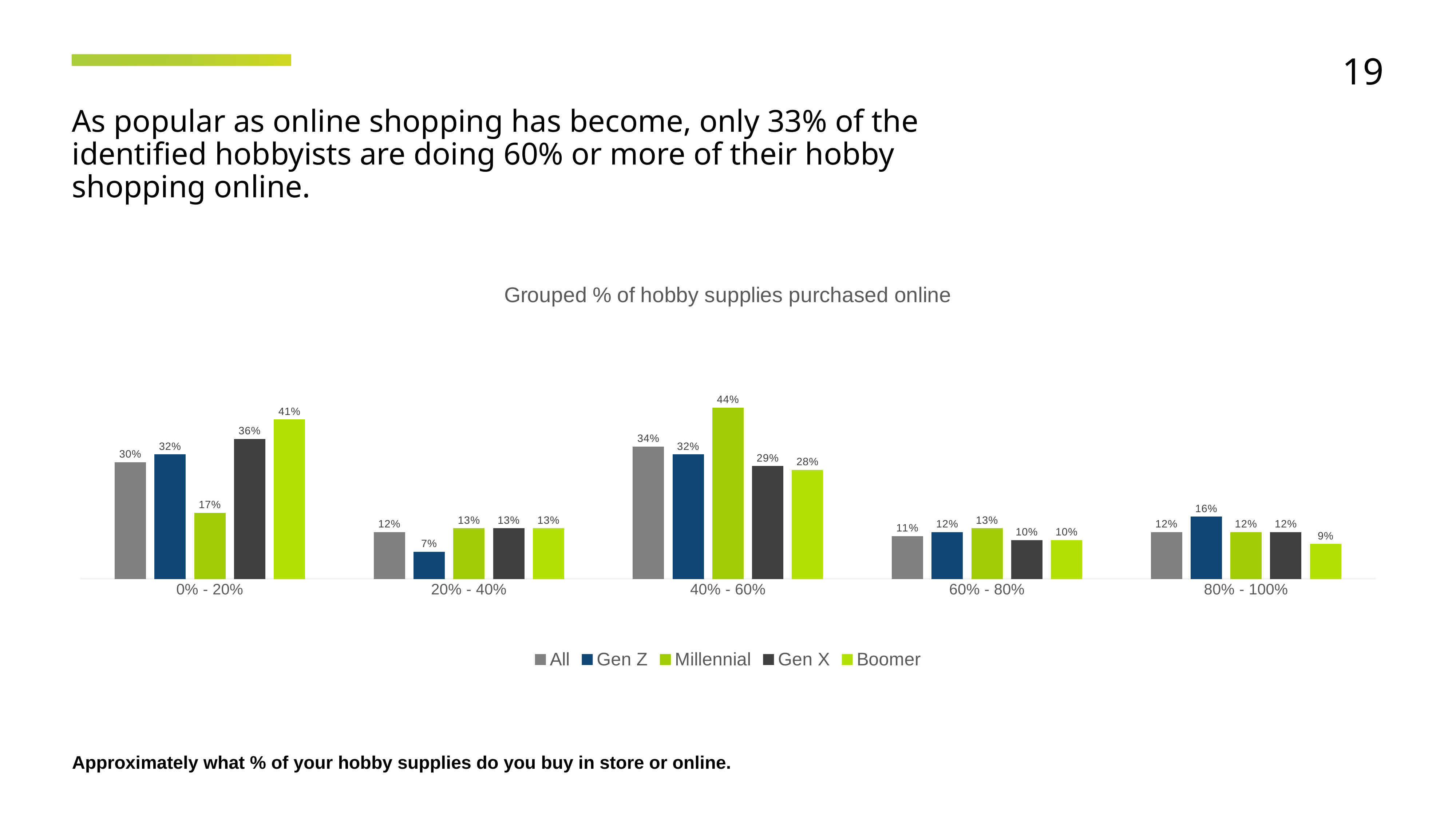
Which series has the lowest value in the 0% - 20% category? Millennial What is the title of the chart? Grouped % of hobby supplies purchased online What is the Millennial value for the 40% - 60% category? 44% What is the Gen Z value for the 20% - 40% category? 7% What is the Boomer value for the 0% - 20% category? 41% Which series has the highest value in the 80% - 100% category? Gen Z Which is larger in the 40% - 60% category: the All value or the Gen X value? All What is the difference between the Boomer and Millennial values in the 0% - 20% category? 24% What kind of chart is shown on the slide? Bar chart What is the Gen X value for the 60% - 80% category? 10% How many categories are shown on the x axis? 5 How many series does the legend list? 5